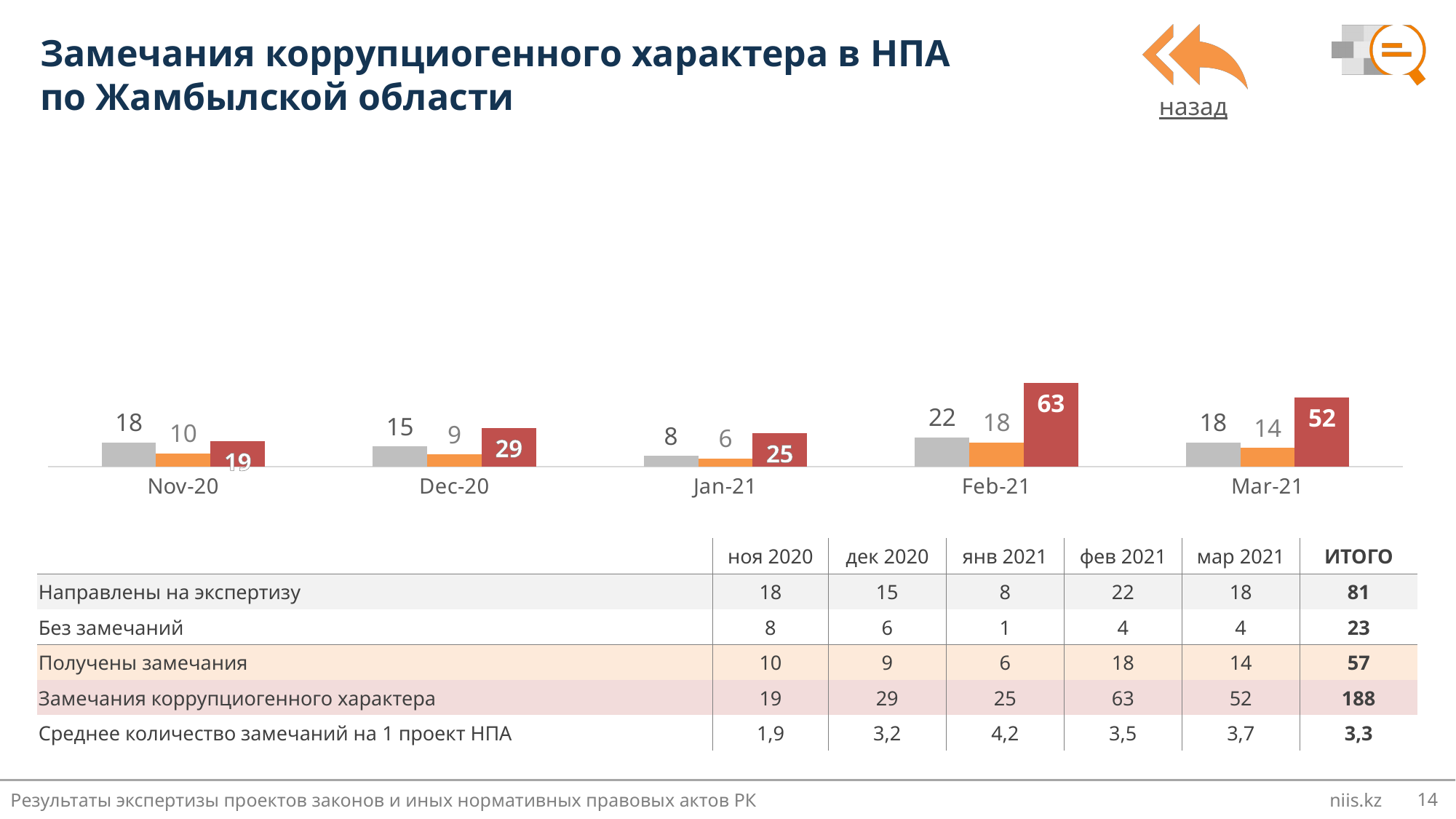
Which is larger: the red bar for Dec-20 or the red bar for Jan-21? Dec-20 What type of chart is shown on the slide? bar chart What is the value of the orange bar (Получены замечания) for Mar-21? 14 What is the difference between the red bar values for Feb-21 and Mar-21? 11 In which month is the grey bar (Направлены на экспертизу) lowest? Jan-21 What is the value of the grey bar (Направлены на экспертизу) for Jan-21? 8 How many bars are shown for each month in the chart? 3 Does the red bar (Замечания коррупциогенного характера) rise or fall from Nov-20 to Dec-20? rise In which month is the red bar (Замечания коррупциогенного характера) highest? Feb-21 What colour is the bar representing Замечания коррупциогенного характера in the chart? red How many months (categories) are shown on the x axis of the chart? 5 What is the value of the red bar (Замечания коррупциогенного характера) for Feb-21? 63